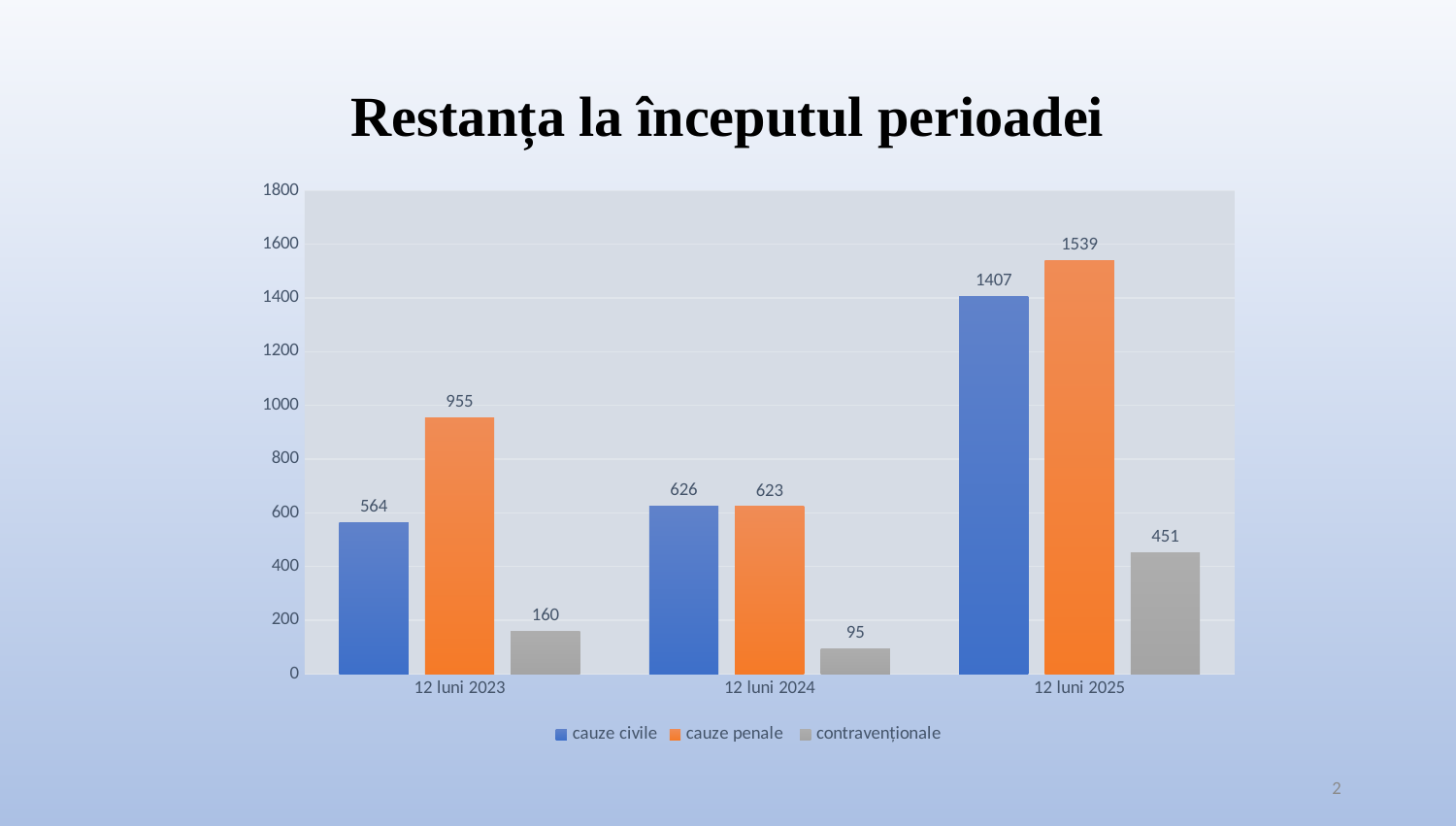
Which category has the highest value for cauze penale? 12 luni 2025 Is the value for cauze civile at 12 luni 2024 greater or less than 800? less What is the difference between cauze penale and cauze civile at 12 luni 2025? 132 How many series does the legend list? 3 What kind of chart is shown on the slide? bar chart What is the value for cauze civile at 12 luni 2023? 564 Which is larger at 12 luni 2023: cauze civile or cauze penale? cauze penale What is the title of the chart? Restanța la începutul perioadei What is the value for cauze penale at 12 luni 2025? 1539 Which category has the lowest value for contravenționale? 12 luni 2024 What is the value for contravenționale at 12 luni 2024? 95 How many categories are shown on the x axis? 3